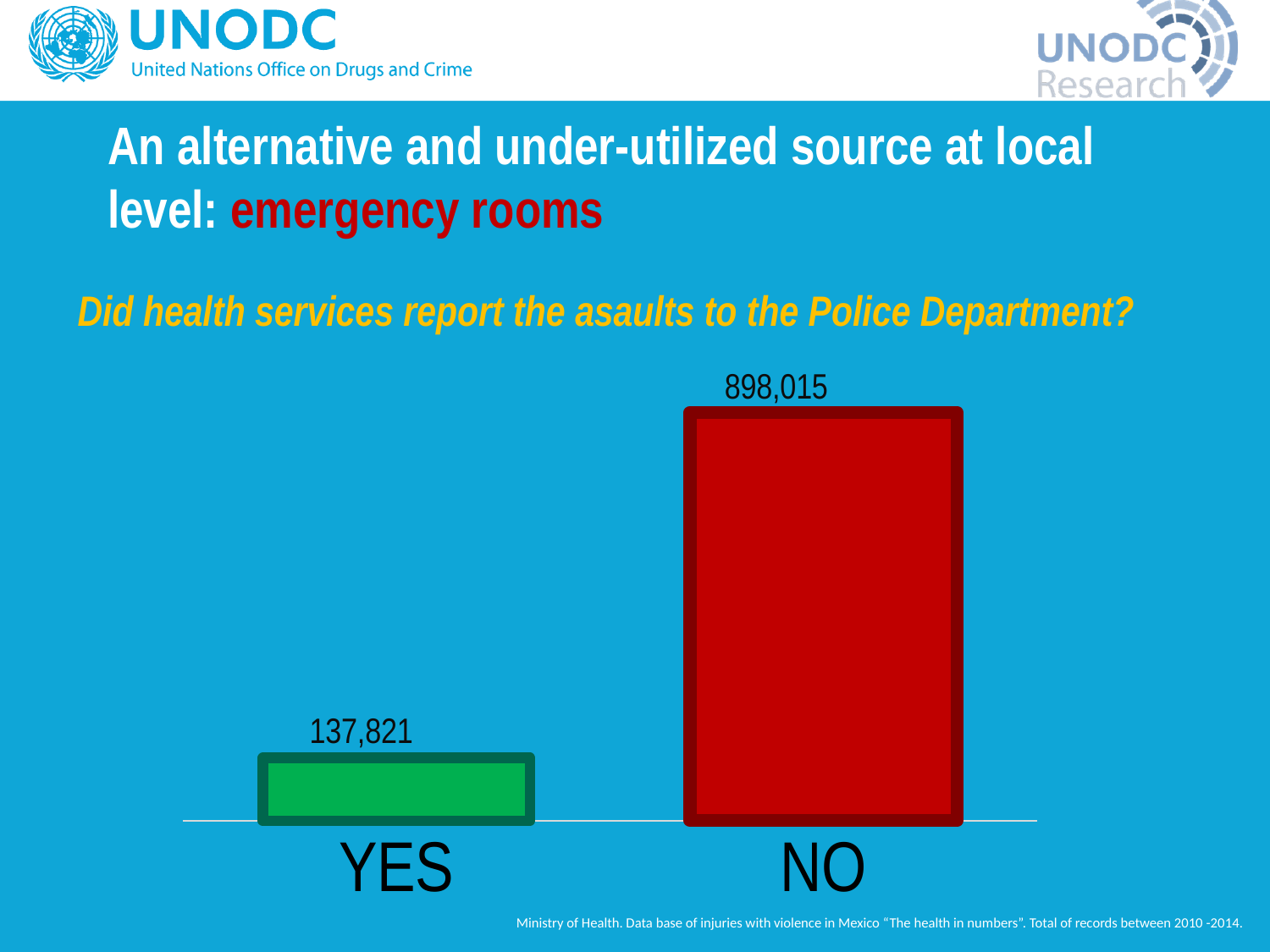
Which is larger, the value for YES or the value for NO? NO What is the total of the YES and NO values? 1,035,836 What colour is the bar for YES? Green What colour is the bar for NO? Red What is the value for NO? 898,015 Which category has the lowest value? YES What is the value for YES? 137,821 Which category has the highest value? NO What is the difference between the NO and YES values? 760,194 How many categories are shown in the chart? 2 What kind of chart is shown on the slide? Bar chart